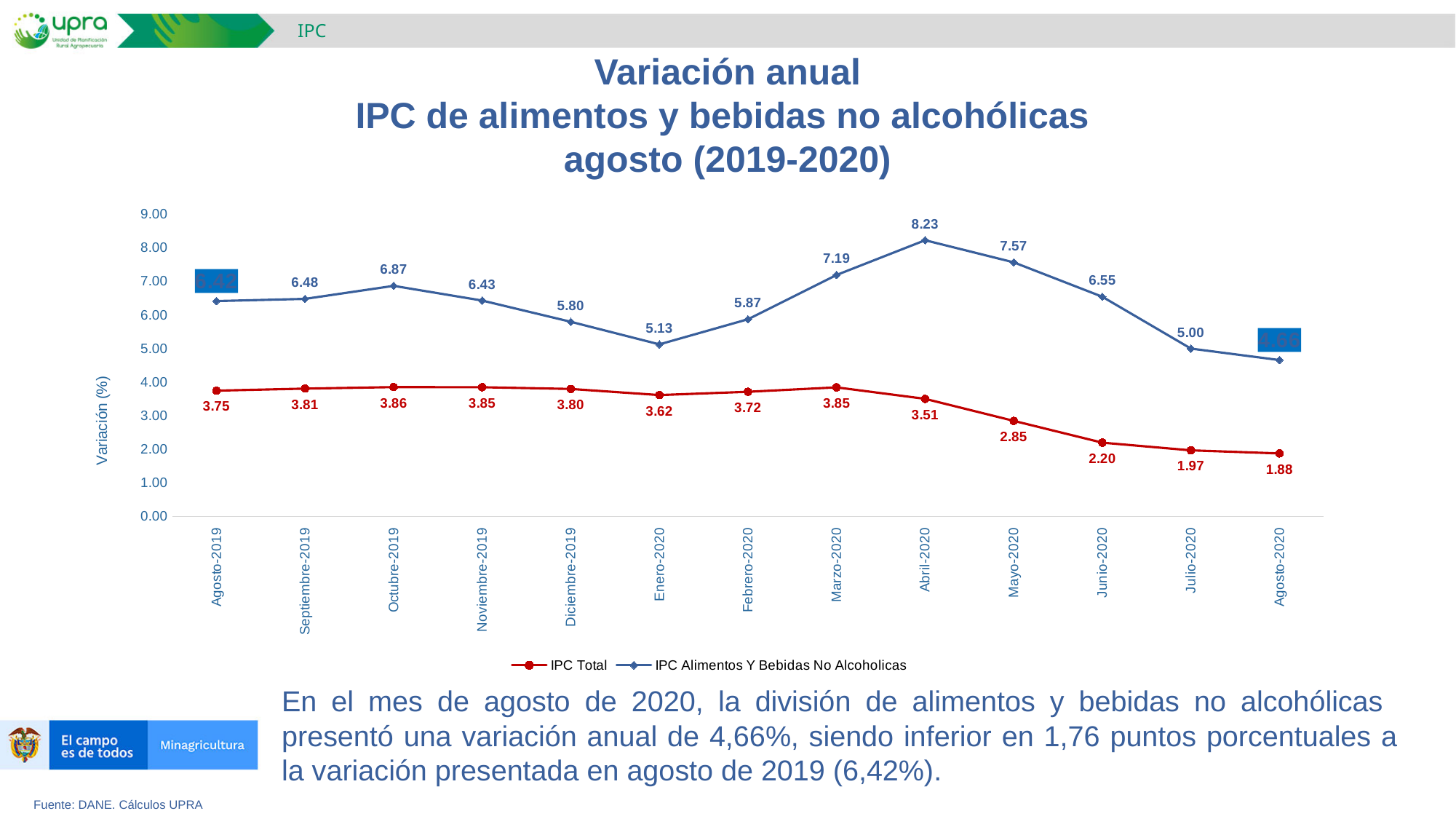
Does IPC Total rise or fall between Marzo-2020 and Agosto-2020? fall What type of chart is shown on the slide? line chart How many months are plotted along the x axis? 13 What is the value of IPC Alimentos Y Bebidas No Alcoholicas in Abril-2020? 8.23 What is the difference between IPC Alimentos Y Bebidas No Alcoholicas and IPC Total in Marzo-2020? 3.34 What is the label of the y axis? Variación (%) What is the value of IPC Alimentos Y Bebidas No Alcoholicas in Enero-2020? 5.13 What is the value of IPC Total in Agosto-2020? 1.88 How many series does the legend list? 2 Which series has the higher value in Junio-2020, IPC Total or IPC Alimentos Y Bebidas No Alcoholicas? IPC Alimentos Y Bebidas No Alcoholicas In which month is IPC Total at its lowest value? Agosto-2020 In which month does IPC Alimentos Y Bebidas No Alcoholicas reach its highest value? Abril-2020